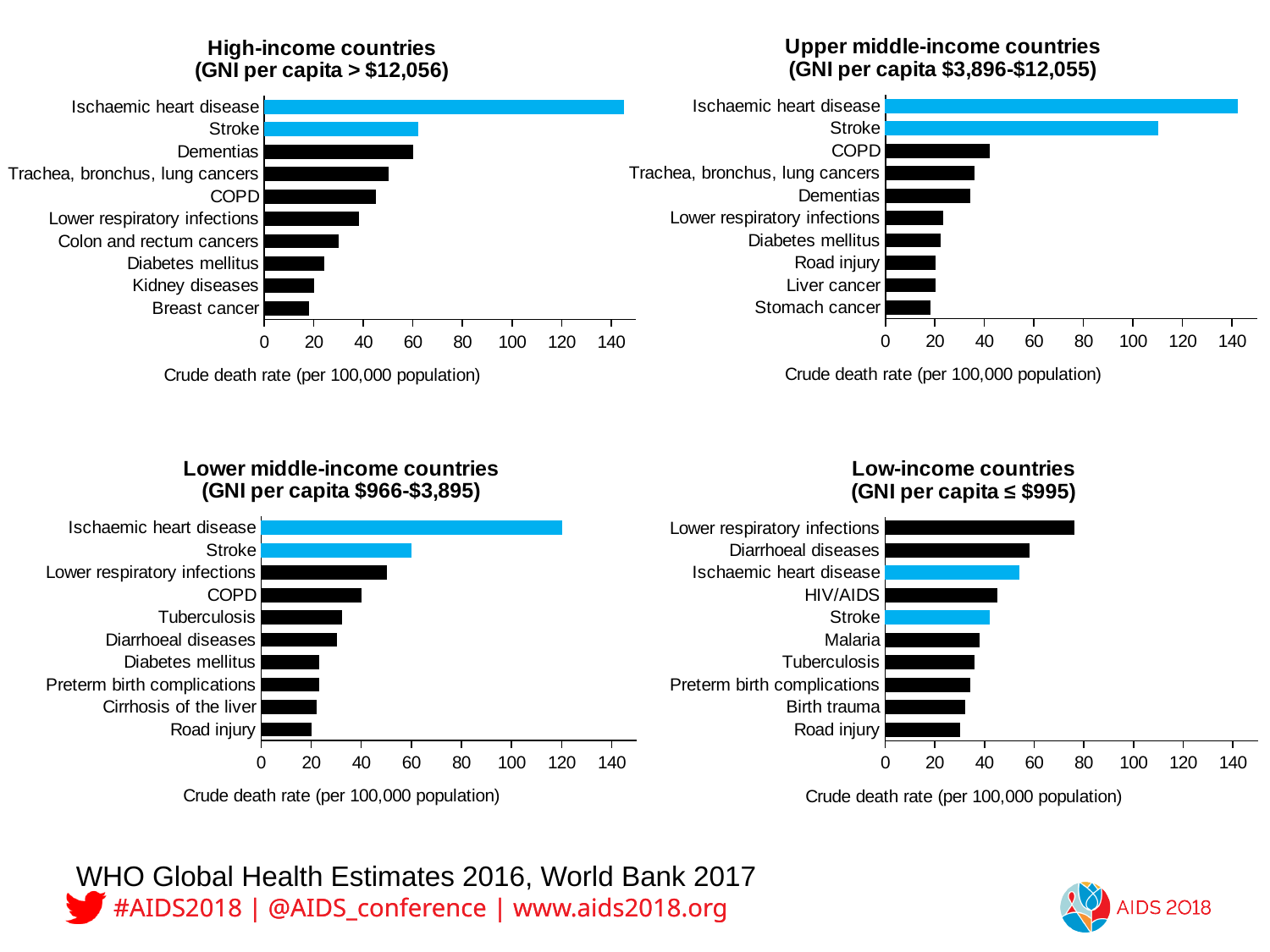
In the Low-income countries chart, is the value for Stroke greater or less than 60? less In the High-income countries chart, is the value for Ischaemic heart disease greater or less than 140? greater In the Upper middle-income countries chart, is the value for Stroke greater or less than 100? greater What kind of chart is the High-income countries chart? bar chart In the High-income countries chart, which cause of death has the lowest crude death rate? Breast cancer In the Low-income countries chart, which cause of death has the highest crude death rate? Lower respiratory infections How many charts are shown on the slide? 4 In the Lower middle-income countries chart, how many causes of death are listed? 10 In the High-income countries chart, which cause of death has the highest crude death rate? Ischaemic heart disease In the Low-income countries chart, which is larger, the value for Diarrhoeal diseases or the value for HIV/AIDS? Diarrhoeal diseases In the Upper middle-income countries chart, which cause of death has the lowest crude death rate? Stomach cancer